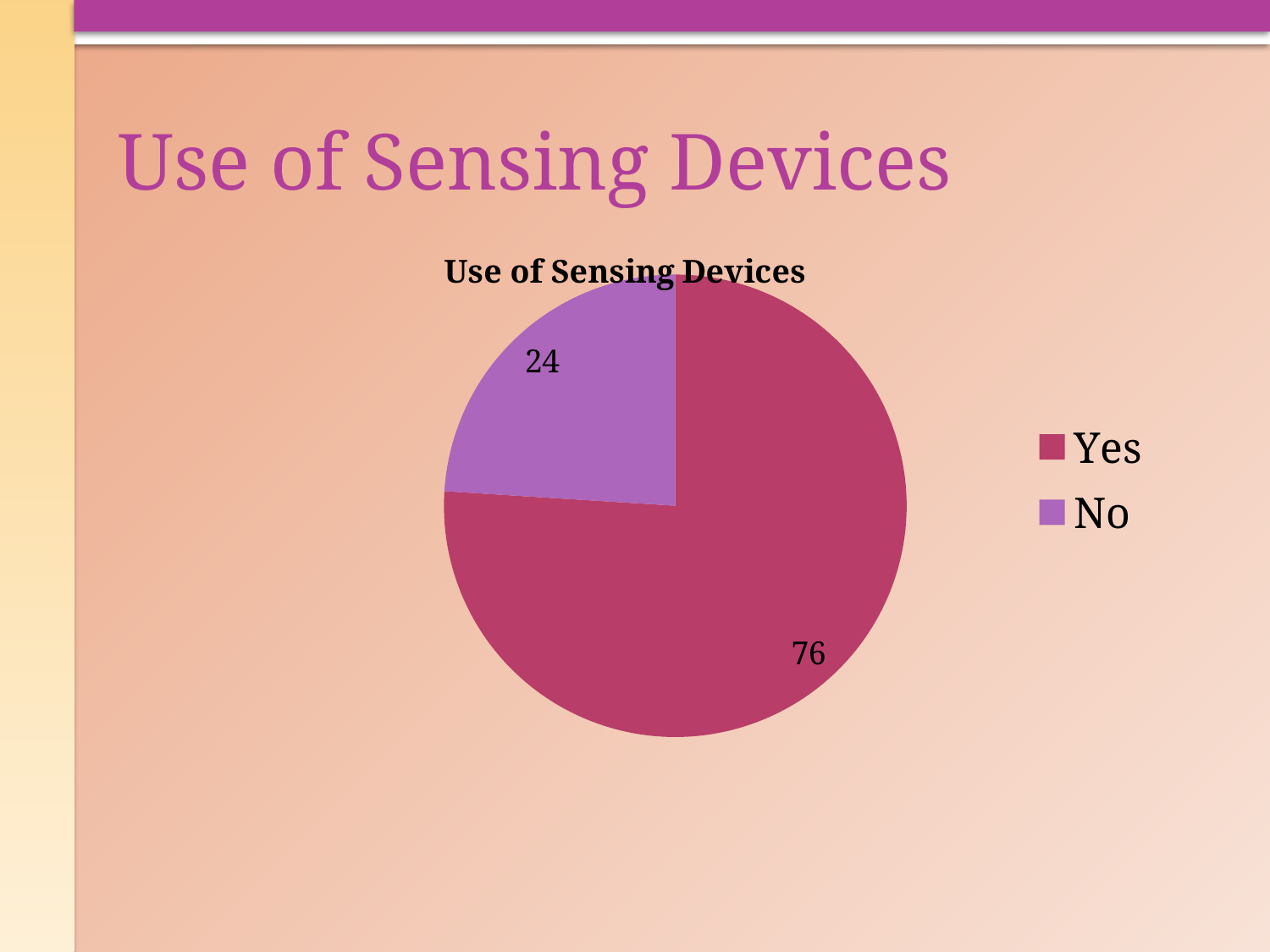
What is the total of the two slice values? 100 What is the difference between the values for Yes and No? 52 What is the title of the chart? Use of Sensing Devices What share of the pie does the No slice represent? 24% Which category has the smallest slice? No What is the value for Yes? 76 Which is larger, the value for Yes or the value for No? Yes How many entries does the legend list? 2 What kind of chart is shown on the slide? Pie chart What is the value for No? 24 Which category has the largest slice? Yes How many slices does the pie chart have? 2